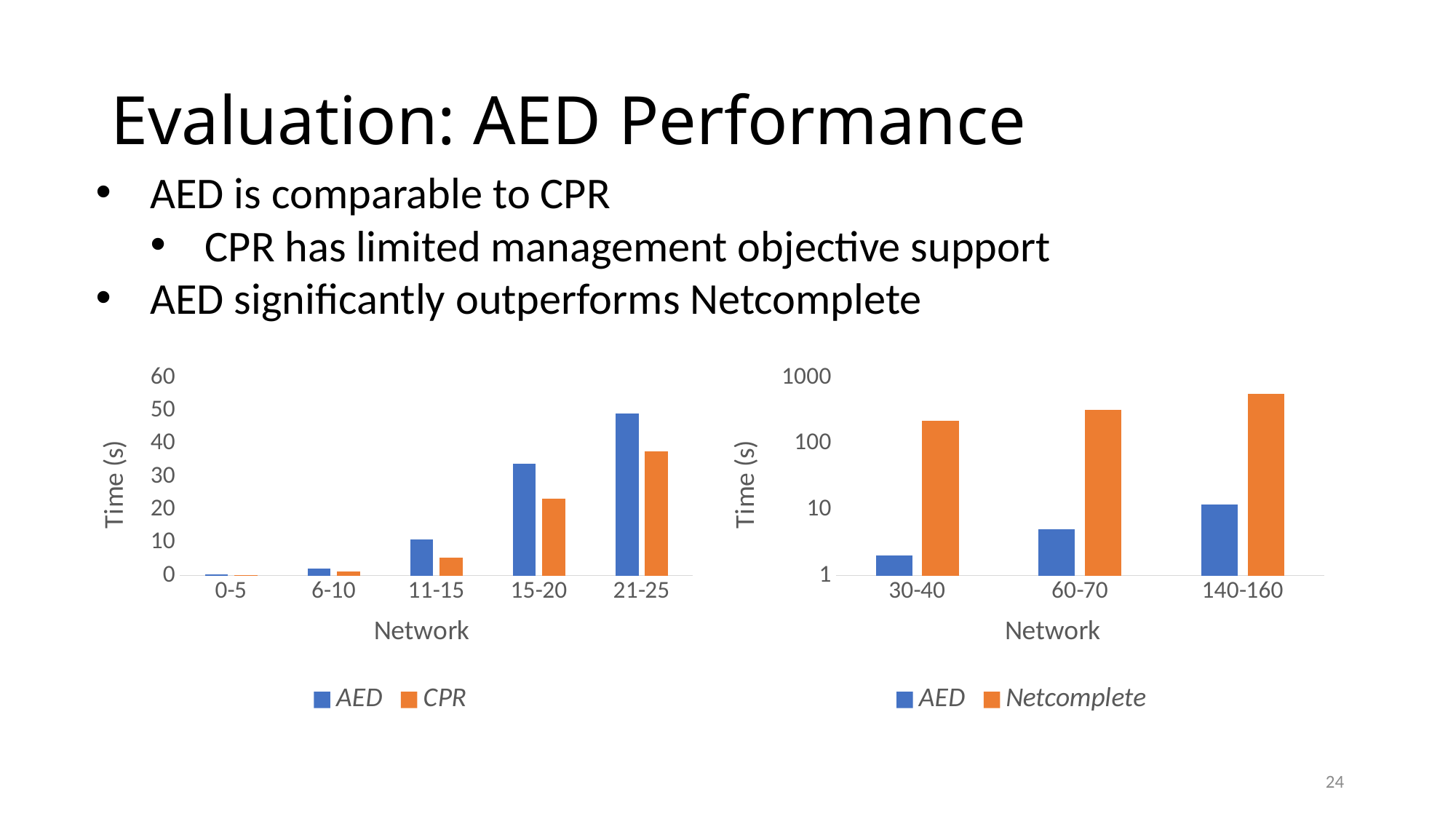
How many network categories are shown on the x axis of the left chart (AED vs CPR)? 5 What is the y axis label of the left chart (AED vs CPR)? Time (s) What kind of chart is the left chart comparing AED and CPR? bar chart How many series does the legend of the right chart (AED vs Netcomplete) list? 2 In the right chart (AED vs Netcomplete), is the Netcomplete time for the 30-40 network category greater or less than 100? greater In the left chart (AED vs CPR), is the AED time for the 15-20 network category greater or less than 30? greater In the right chart (AED vs Netcomplete), for the 140-160 network category, which series has the larger time, AED or Netcomplete? Netcomplete In the left chart (AED vs CPR), for the 21-25 network category, which series has the larger time, AED or CPR? AED In the right chart (AED vs Netcomplete), do the Netcomplete times rise or fall as the network size increases along the x axis? rise How many network categories are shown on the x axis of the right chart (AED vs Netcomplete)? 3 In the left chart (AED vs CPR), which network category has the highest AED time? 21-25 In the left chart (AED vs CPR), which network category has the lowest CPR time? 0-5